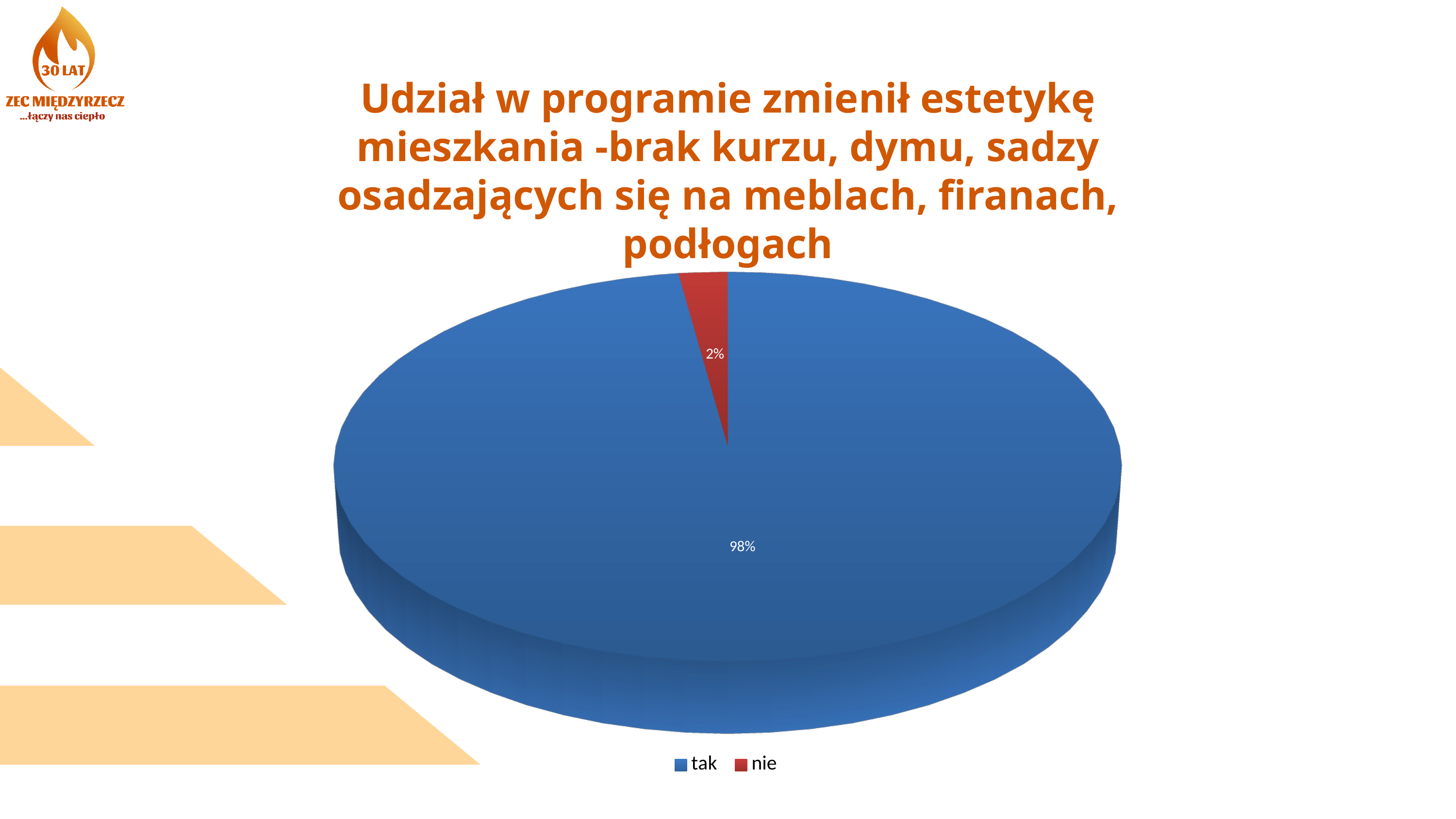
Which slice is larger, "tak" or "nie"? tak What share of the pie does "tak" have? 98% How many categories does the pie chart show? 2 Which category has the largest slice of the pie? tak What colour is the "tak" slice? blue What share of the pie does "nie" have? 2% What colour is the "nie" slice? red How many entries does the legend list? 2 Which category has the smallest slice of the pie? nie What is the difference in percentage points between the "tak" and "nie" slices? 96 What kind of chart is shown on the slide? pie chart